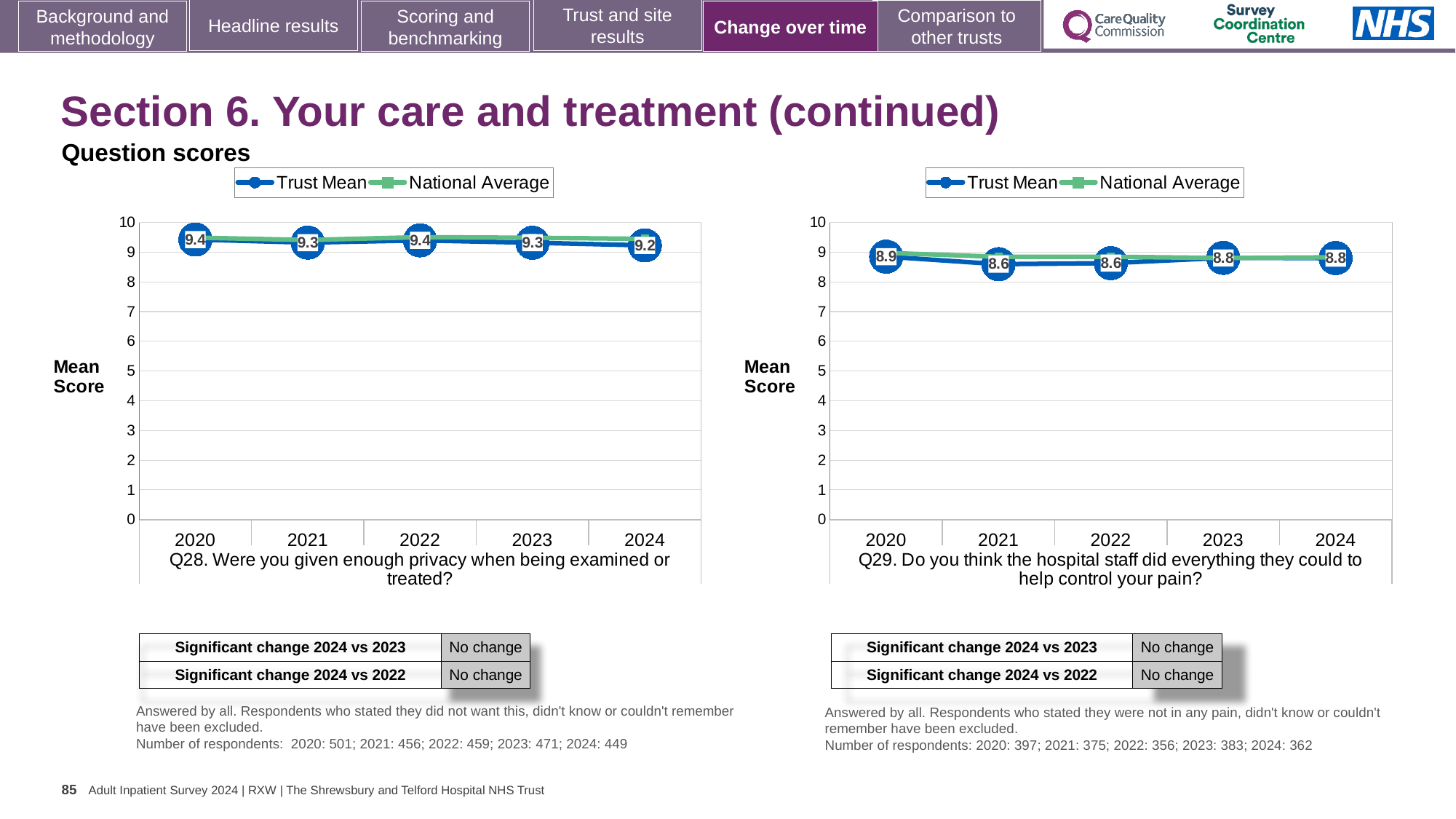
On the Q29 chart, what is the Trust Mean score for 2023? 8.8 How many series does the legend of the Q29 chart list? 2 On the Q28 chart, which year has the lowest Trust Mean score? 2024 On the Q28 chart, what is the Trust Mean score for 2024? 9.2 On the Q29 chart, what is the difference between the Trust Mean score in 2020 and in 2021? 0.3 How many years are plotted on the Q28 chart? 5 On the Q29 chart, what is the Trust Mean score for 2021? 8.6 On the Q28 chart, is the Trust Mean score higher in 2022 or in 2024? 2022 On the Q28 chart, what is the Trust Mean score for 2020? 9.4 On the Q29 chart, which year has the highest Trust Mean score? 2020 On the Q29 chart, is the National Average value for 2022 greater or less than 8? greater What type of chart is used for Q28? Line chart